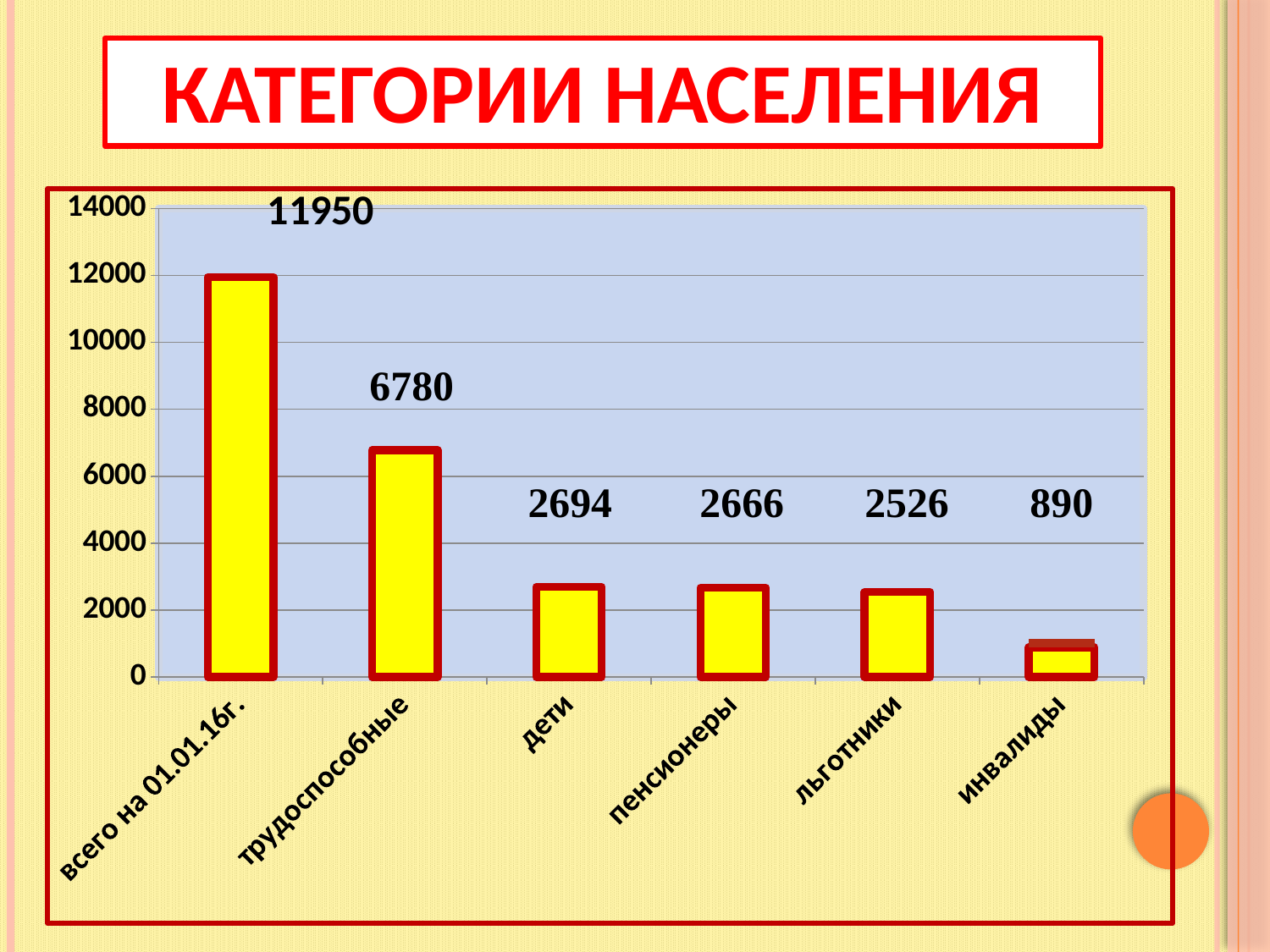
What is the value for пенсионеры? 2666 How many categories are shown on the x axis? 6 What is the difference between the values for льготники and инвалиды? 1636 What is the title of the slide? КАТЕГОРИИ НАСЕЛЕНИЯ What is the difference between the values for трудоспособные and дети? 4086 What is the value for инвалиды? 890 Which is larger, the value for трудоспособные or the value for пенсионеры? трудоспособные What is the value for трудоспособные? 6780 Which category has the lowest value? инвалиды Which category has the highest value? всего на 01.01.16г. What is the value for всего на 01.01.16г.? 11950 What kind of chart is shown on the slide? bar chart